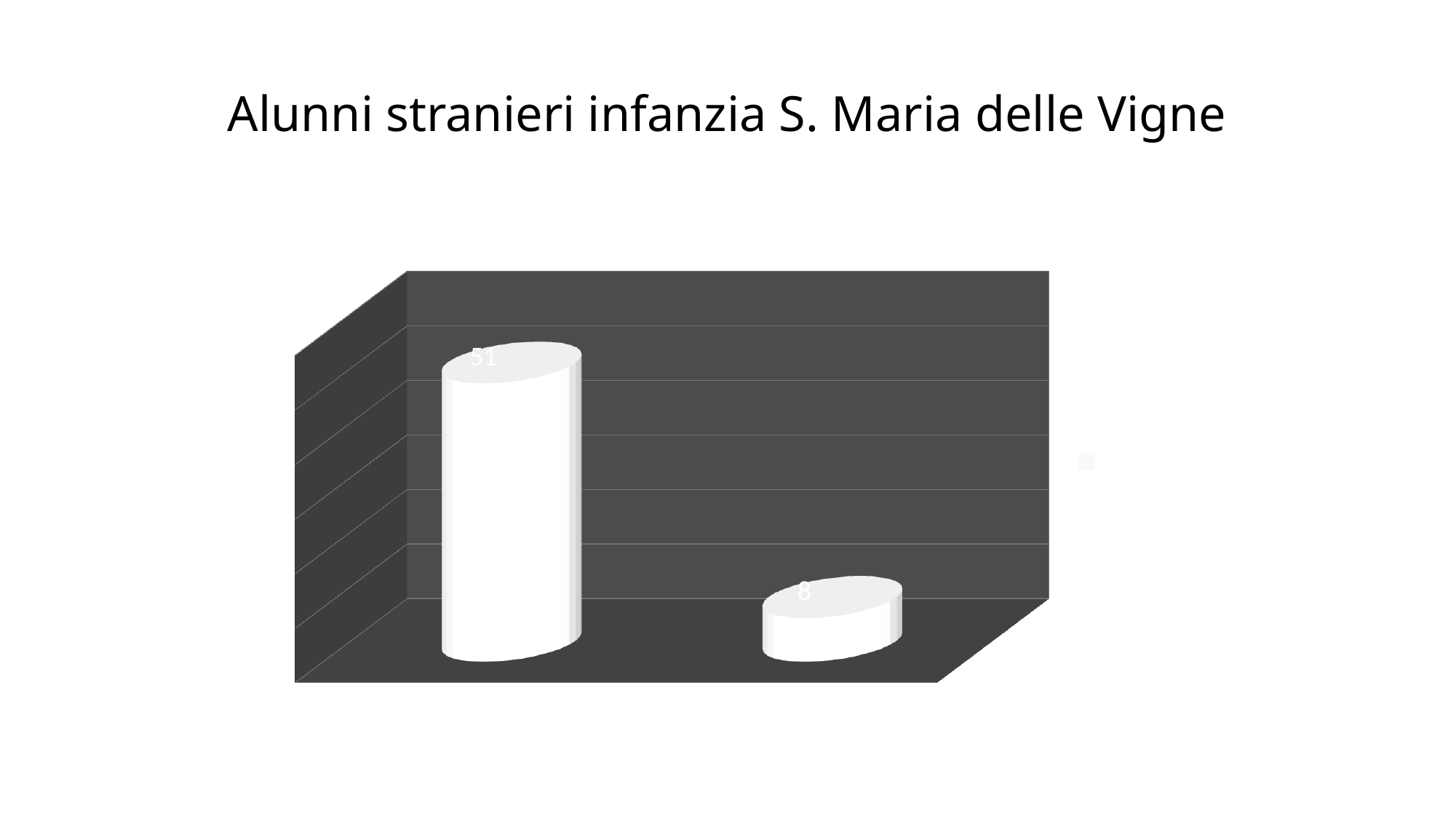
What is the difference between the values of the left bar and the right bar? 43 Do the values rise or fall from left to right across the chart? fall What is the value shown on the right bar of the chart? 8 What colour are the bars in the chart? white How many bars are plotted in the chart? 2 What is the value shown on the left bar of the chart? 51 Which bar has the larger value, the left one or the right one? the left one What is the title of the chart on the slide? Alunni stranieri infanzia S. Maria delle Vigne What kind of chart is shown on the slide? bar chart What is the highest value plotted in the chart? 51 What is the lowest value plotted in the chart? 8